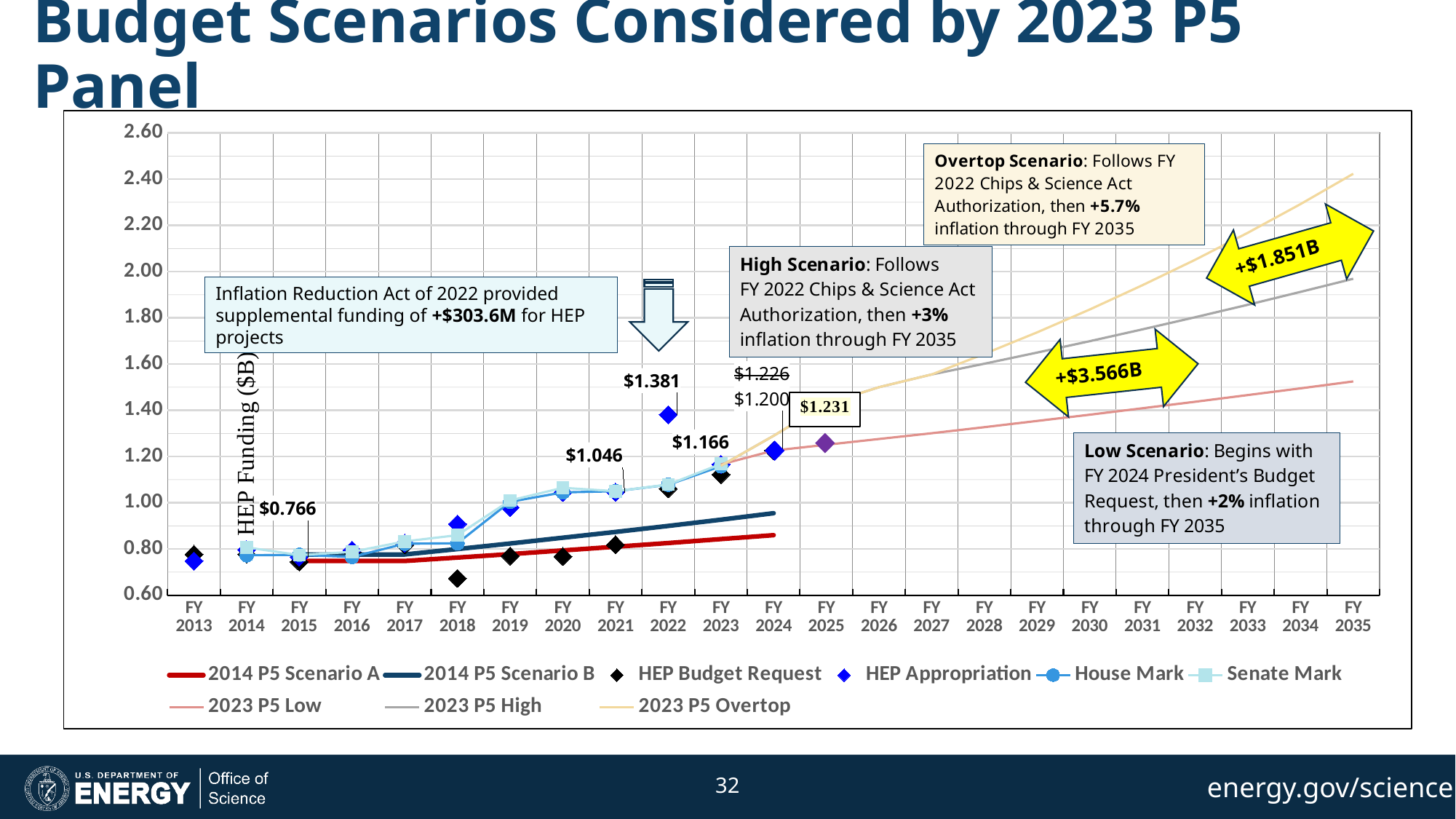
At FY 2035, which is higher: 2023 P5 High or 2023 P5 Low? 2023 P5 High Does the 2023 P5 Overtop line rise or fall from FY 2024 to FY 2035? rise Is the 2023 P5 Low value at FY 2035 greater or less than 1.60? less What is the difference between the labelled FY 2022 value ($1.381) and the labelled FY 2023 value ($1.166)? $0.215 How many series does the legend list? 9 What kind of chart is shown on the slide? line chart What is the labelled HEP Appropriation value for FY 2022? $1.381 What is the labelled value for FY 2025? $1.231 What is the labelled value for FY 2023? $1.166 What is the labelled value for FY 2021? $1.046 Is the 2023 P5 Overtop value at FY 2035 greater or less than 2.20? greater How many fiscal years are shown along the x axis? 23